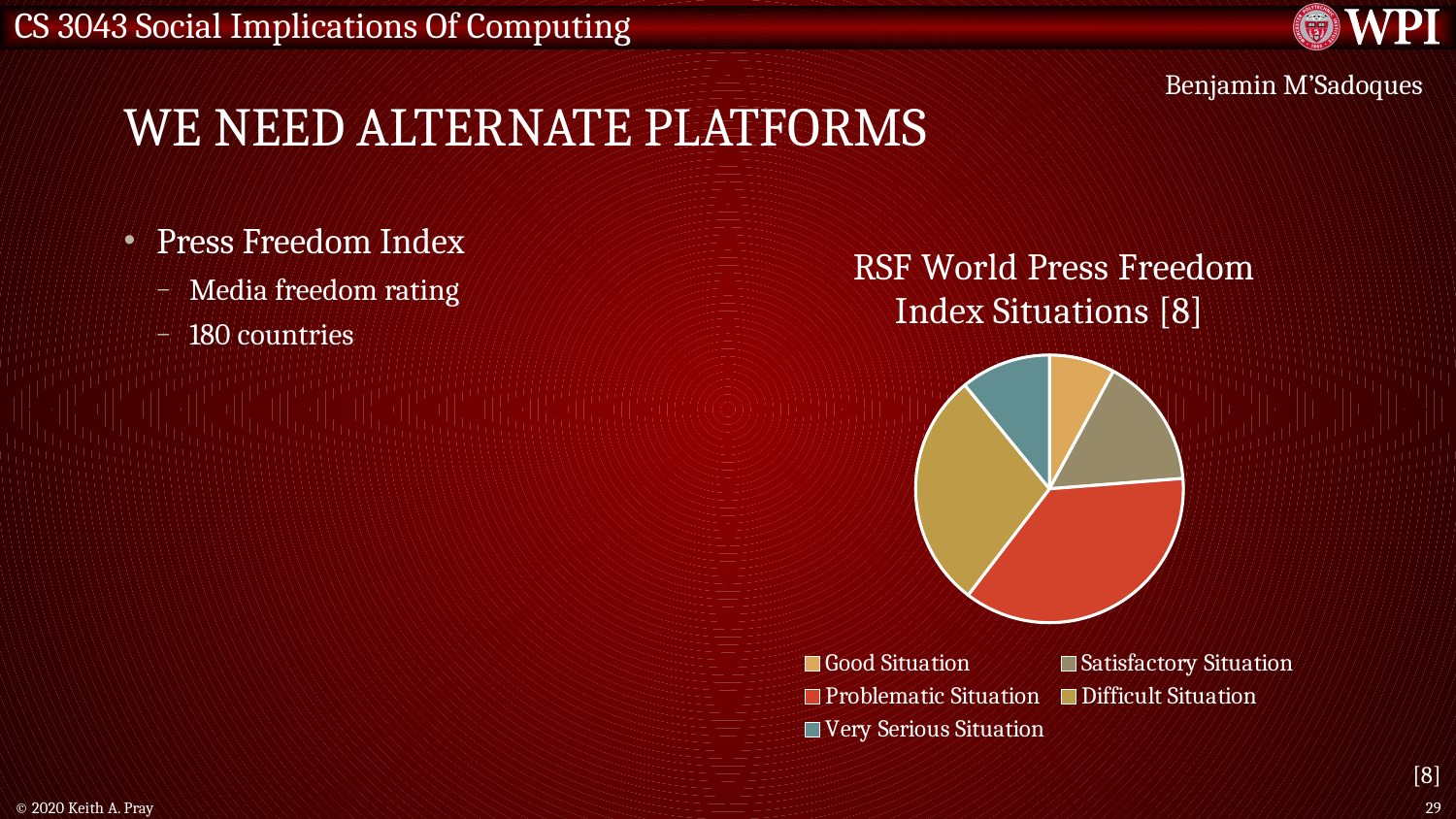
What kind of chart is shown on the slide? pie chart How many entries does the chart's legend list? 5 What colour is the slice for Problematic Situation? red What is the title of the chart? RSF World Press Freedom Index Situations [8] How many slices does the pie chart have? 5 Which is larger, the slice for Satisfactory Situation or the slice for Good Situation? Satisfactory Situation Which is larger, the slice for Problematic Situation or the slice for Difficult Situation? Problematic Situation Which category has the largest slice of the pie? Problematic Situation Which is larger, the slice for Difficult Situation or the slice for Very Serious Situation? Difficult Situation